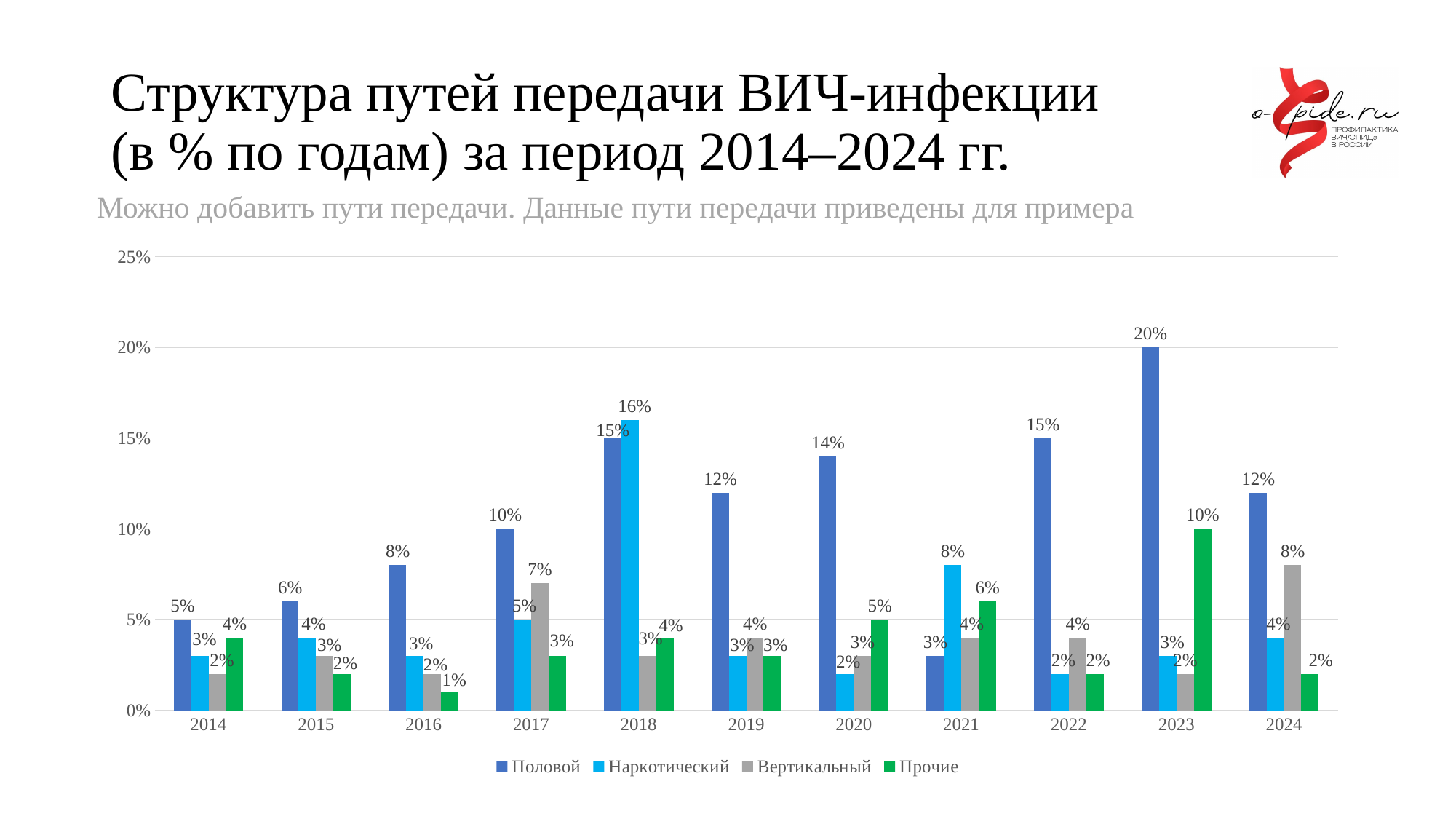
What is the value for Прочие in 2021? 6% What is the value for Половой in 2023? 20% In which year is the Половой series highest? 2023 What is the value for Вертикальный in 2024? 8% What is the difference between the Половой value in 2023 and the Половой value in 2024? 8% How many years are shown on the x axis? 11 What kind of chart is shown on the slide? Bar chart Which series is shown in green in the legend? Прочие In which year is the Прочие series lowest? 2016 Which is larger in 2018: Половой or Наркотический? Наркотический What is the value for Наркотический in 2018? 16% How many series does the legend list? 4